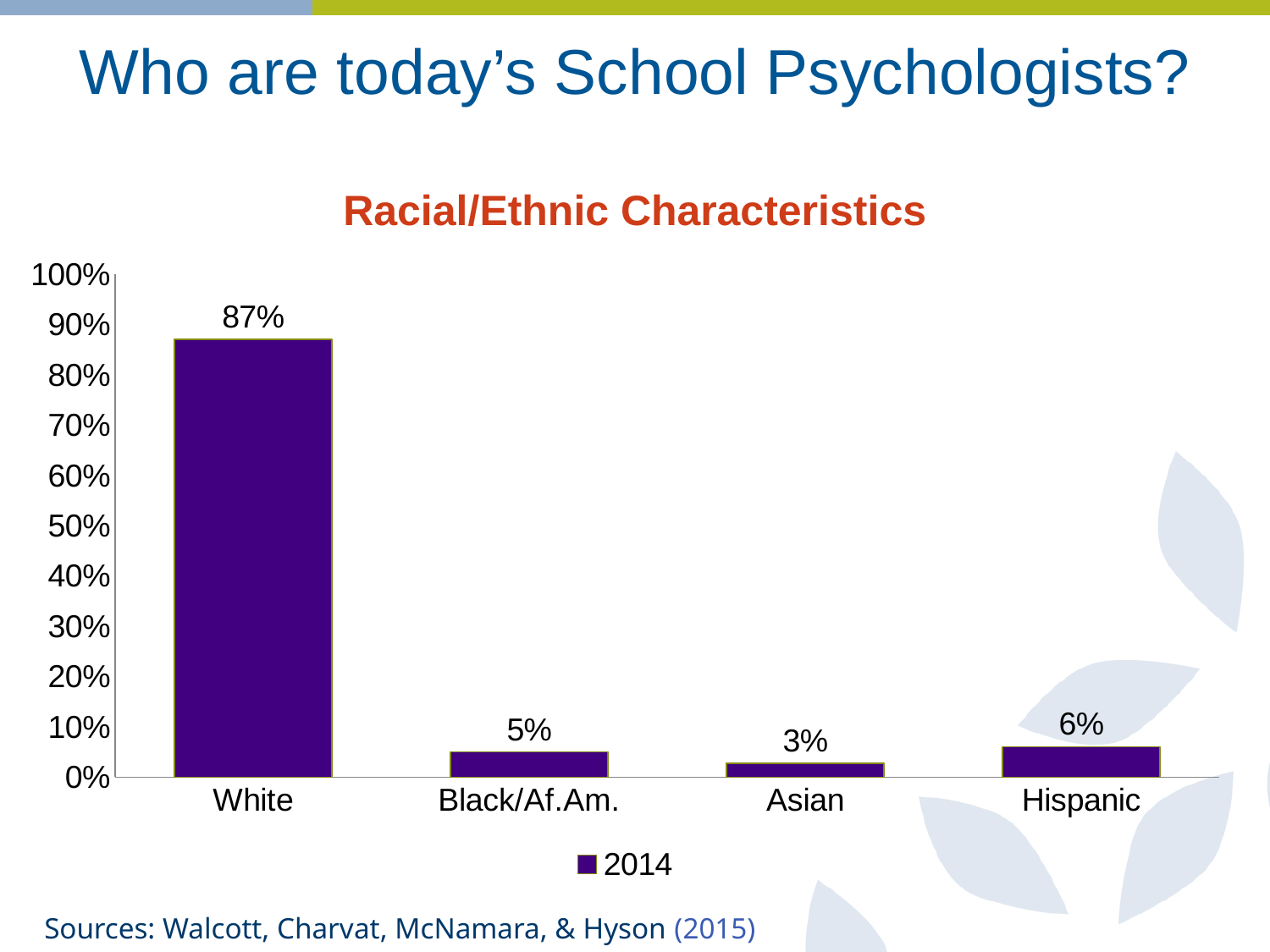
What series does the legend list? 2014 What is the value for Black/Af.Am.? 5% Which category has the highest value? White What is the difference between the values for White and Hispanic? 81% What is the difference between the values for Hispanic and Asian? 3% What is the value for Hispanic? 6% What is the value for White? 87% What kind of chart is shown on the slide? Bar chart How many categories are shown on the x axis? 4 What is the value for Asian? 3% Which is larger, the value for Black/Af.Am. or the value for Hispanic? Hispanic Which category has the lowest value? Asian